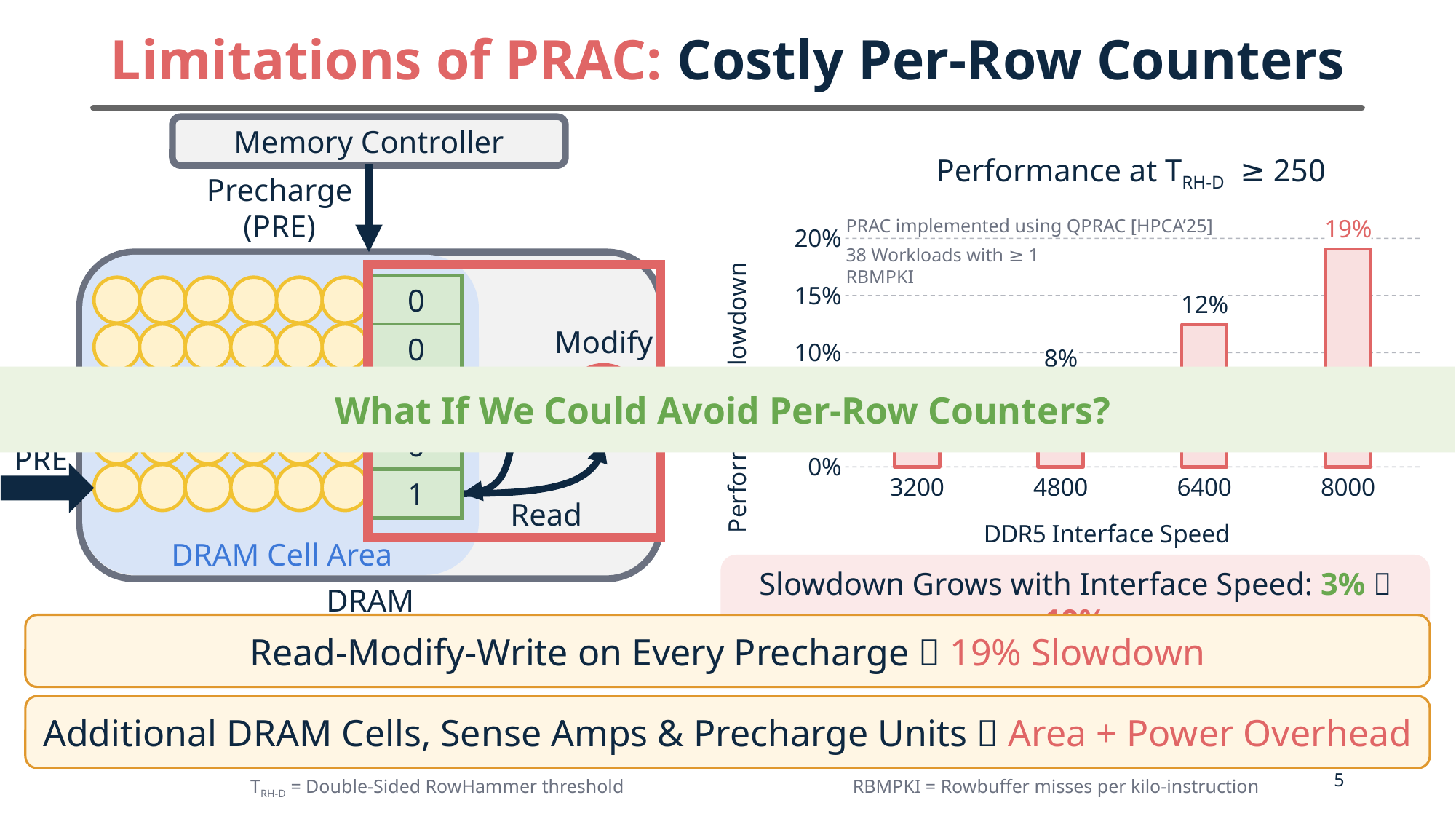
What is the performance slowdown at a DDR5 interface speed of 6400? 12% What is the performance slowdown at a DDR5 interface speed of 4800? 8% Which has a larger performance slowdown, interface speed 4800 or 6400? 6400 What kind of chart is used to show performance slowdown versus DDR5 interface speed? bar chart Is the performance slowdown at interface speed 3200 greater or less than 10%? less What is the difference in performance slowdown between interface speeds 8000 and 6400? 7% Which DDR5 interface speed has the lowest performance slowdown? 3200 What is the performance slowdown at a DDR5 interface speed of 8000? 19% How many DDR5 interface speeds are plotted in the chart? 4 Does the performance slowdown rise or fall as the DDR5 interface speed increases? rise Which DDR5 interface speed has the highest performance slowdown? 8000 What is the difference in performance slowdown between interface speeds 6400 and 4800? 4%